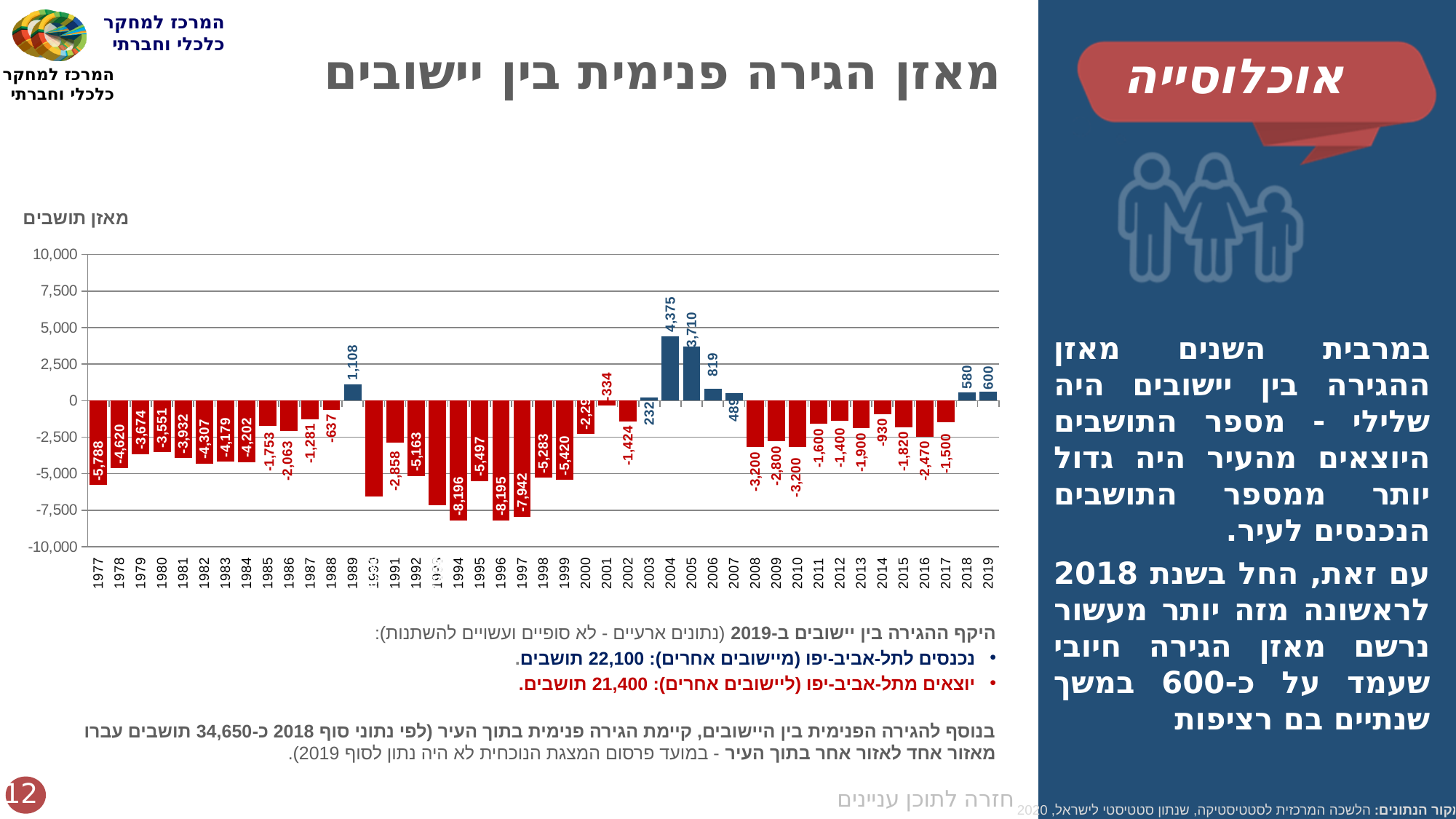
What is the title of the chart on the slide? מאזן הגירה פנימית בין יישובים Which is larger, the value for 2018 or the value for 2019? 2019 What is the value for 1977? -5,788 Which year has the highest value in the chart? 2004 How many years are shown on the x axis of the chart? 43 What is the value for 1989? 1,108 What is the value for 2019? 600 What is the label shown above the vertical axis of the chart? מאזן תושבים What is the difference between the values for 2004 and 2005? 665 Is the value for 1990 greater or less than -5,000? less What type of chart is shown on the slide? bar chart What is the value for 2004? 4,375